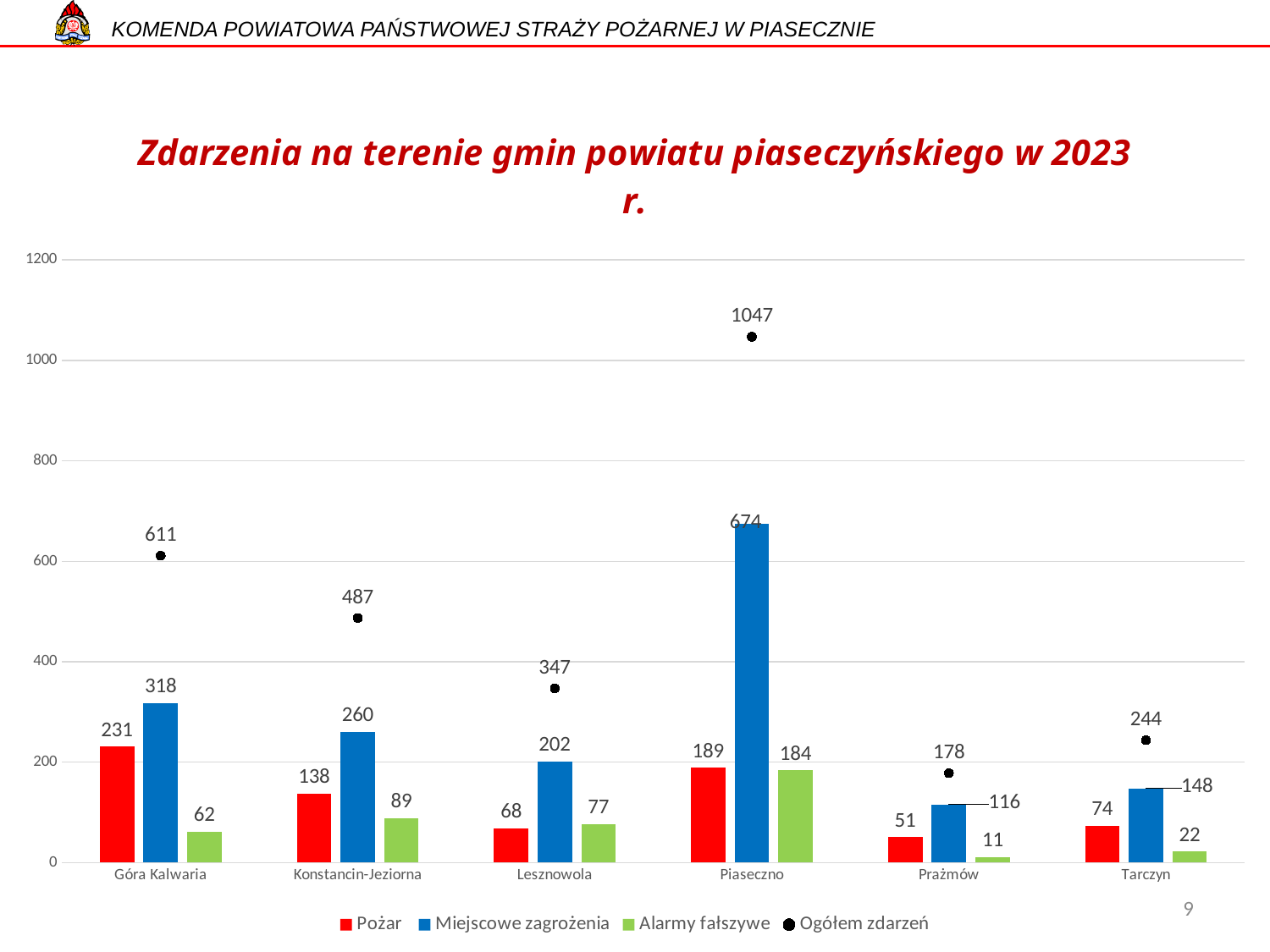
Which gmina has the lowest value of Pożar? Prażmów What kind of chart is shown on the slide? Bar chart How many gminy (categories) are shown on the x axis? 6 What is the value of Alarmy fałszywe for Prażmów? 11 What is the value of Pożar for Góra Kalwaria? 231 What is the difference between Miejscowe zagrożenia for Piaseczno and for Góra Kalwaria? 356 Which gmina has the highest value of Ogółem zdarzeń? Piaseczno What is the value of Miejscowe zagrożenia for Piaseczno? 674 How many series does the legend list? 4 What is the value of Ogółem zdarzeń for Lesznowola? 347 Which is larger: Alarmy fałszywe for Konstancin-Jeziorna or for Lesznowola? Konstancin-Jeziorna Is the value of Ogółem zdarzeń for Konstancin-Jeziorna greater or less than 400? greater